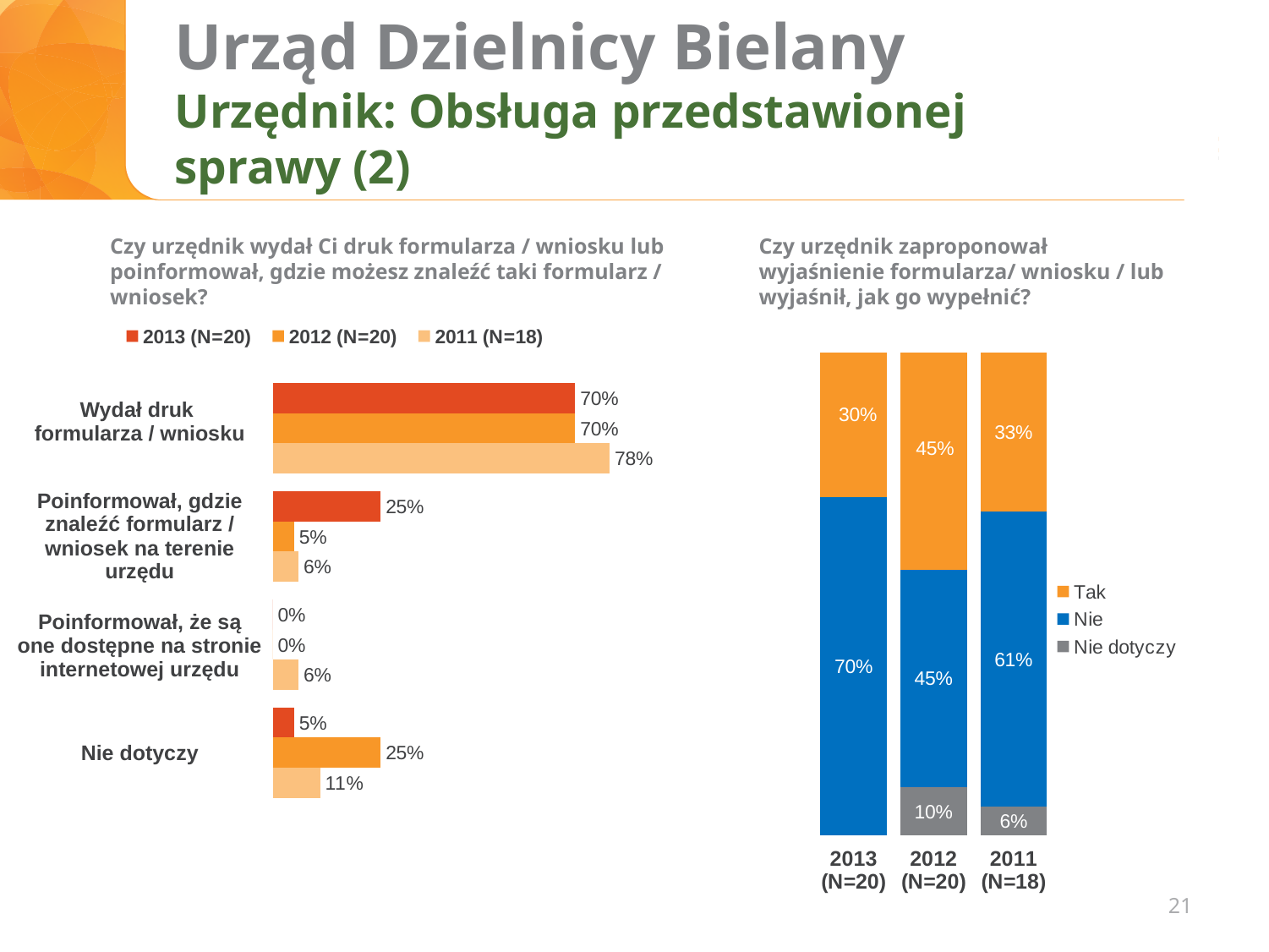
In the left chart, how many categories are shown? 4 In the left chart, what is the value for 2013 (N=20) for 'Poinformował, gdzie znaleźć formularz / wniosek na terenie urzędu'? 25% In the left chart, which category has the highest value for 2013 (N=20)? Wydał druk formularza / wniosku What kind of chart is the right chart? Stacked bar chart In the right chart, is the 'Nie' value for 2011 (N=18) larger or smaller than the 'Nie' value for 2012 (N=20)? larger In the left chart, what is the difference between the 2011 (N=18) and 2013 (N=20) values for 'Wydał druk formularza / wniosku'? 8% In the left chart, what is the value for 2011 (N=18) for 'Wydał druk formularza / wniosku'? 78% In the right chart, what is the 'Nie' value for 2013 (N=20)? 70% In the right chart, what is the 'Nie dotyczy' value for 2012 (N=20)? 10% In the left chart, what is the value for 2012 (N=20) for 'Nie dotyczy'? 25% In the left chart, how many series does the legend list? 3 In the right chart, which year has the highest 'Tak' value? 2012 (N=20)